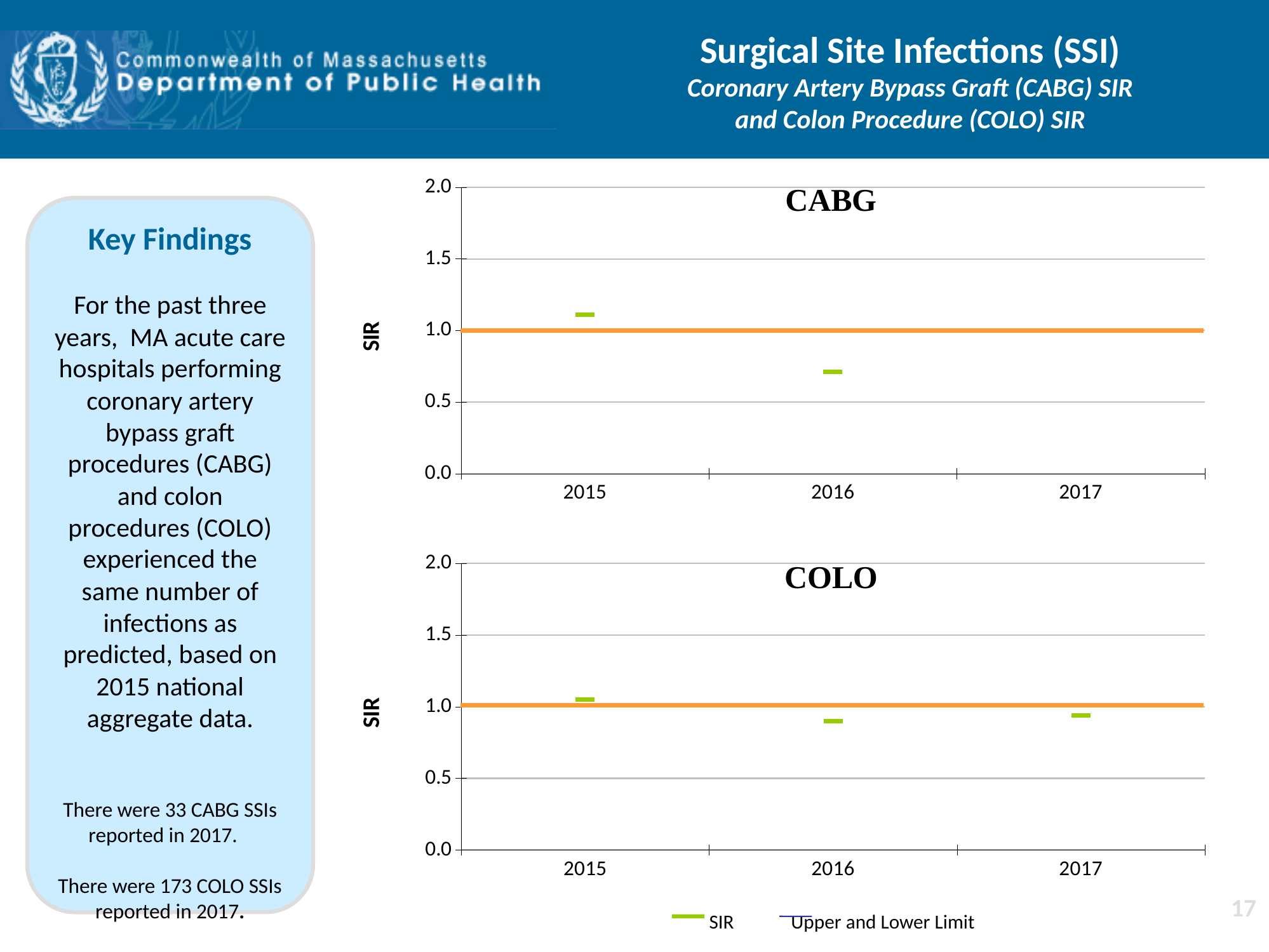
In the CABG chart, is the SIR value for 2016 greater or less than 0.5? greater In the COLO chart, is the SIR value for 2017 greater or less than 1.5? less In the CABG chart, is the SIR value for 2016 greater or less than 1.0? less In the COLO chart, which year has the highest SIR value? 2015 How many series does the legend below the charts list? 2 What does the orange line in the charts represent, according to the legend? Upper and Lower Limit In the COLO chart, which year has the larger SIR value, 2015 or 2016? 2015 In the CABG chart, which year has the larger SIR value, 2015 or 2016? 2015 How many years are shown on the x axis of the COLO chart? 3 What is the label on the y axis of the CABG chart? SIR